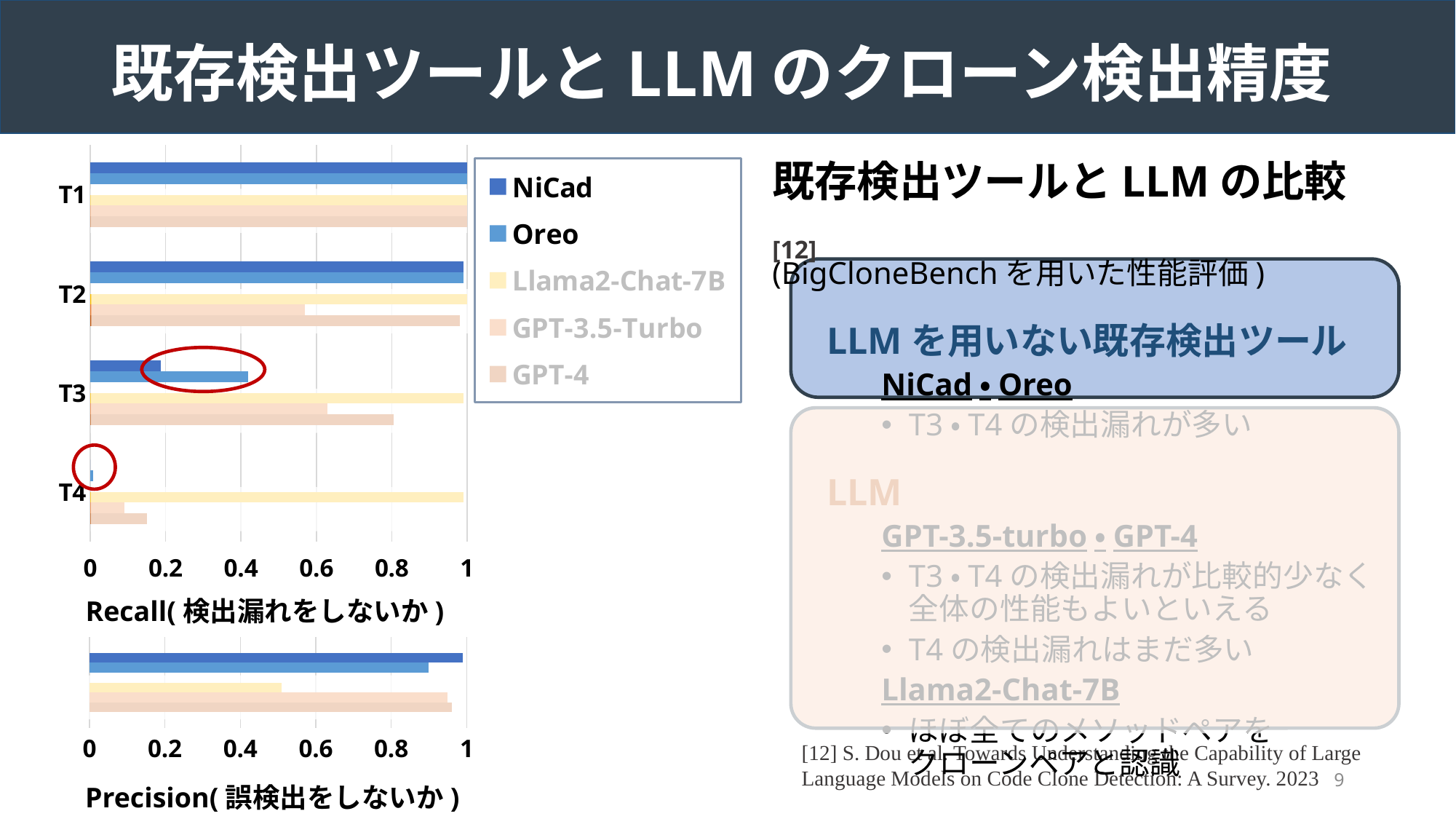
In the Recall chart at T3, which is larger, NiCad or Oreo? Oreo In the Recall chart, is the value for Oreo at T3 greater or less than 0.2? greater In the Precision chart, which series has the lowest value? Llama2-Chat-7B In the Recall chart at T2, which is larger, GPT-3.5-Turbo or GPT-4? GPT-4 What is the axis label printed under the top chart? Recall( 検出漏れをしないか ) In the Recall chart, which series has the highest value at T4? Llama2-Chat-7B What kind of chart is the Recall chart on the slide? bar chart In the Recall chart, does the value for NiCad rise or fall going from T1 to T4? fall How many series does the legend list? 5 In the Recall chart, how many categories (clone types) are shown on the vertical axis? 4 In the Recall chart, is the value for NiCad at T3 greater or less than 0.4? less In the Recall chart, is the value for Oreo at T4 greater or less than 0.2? less